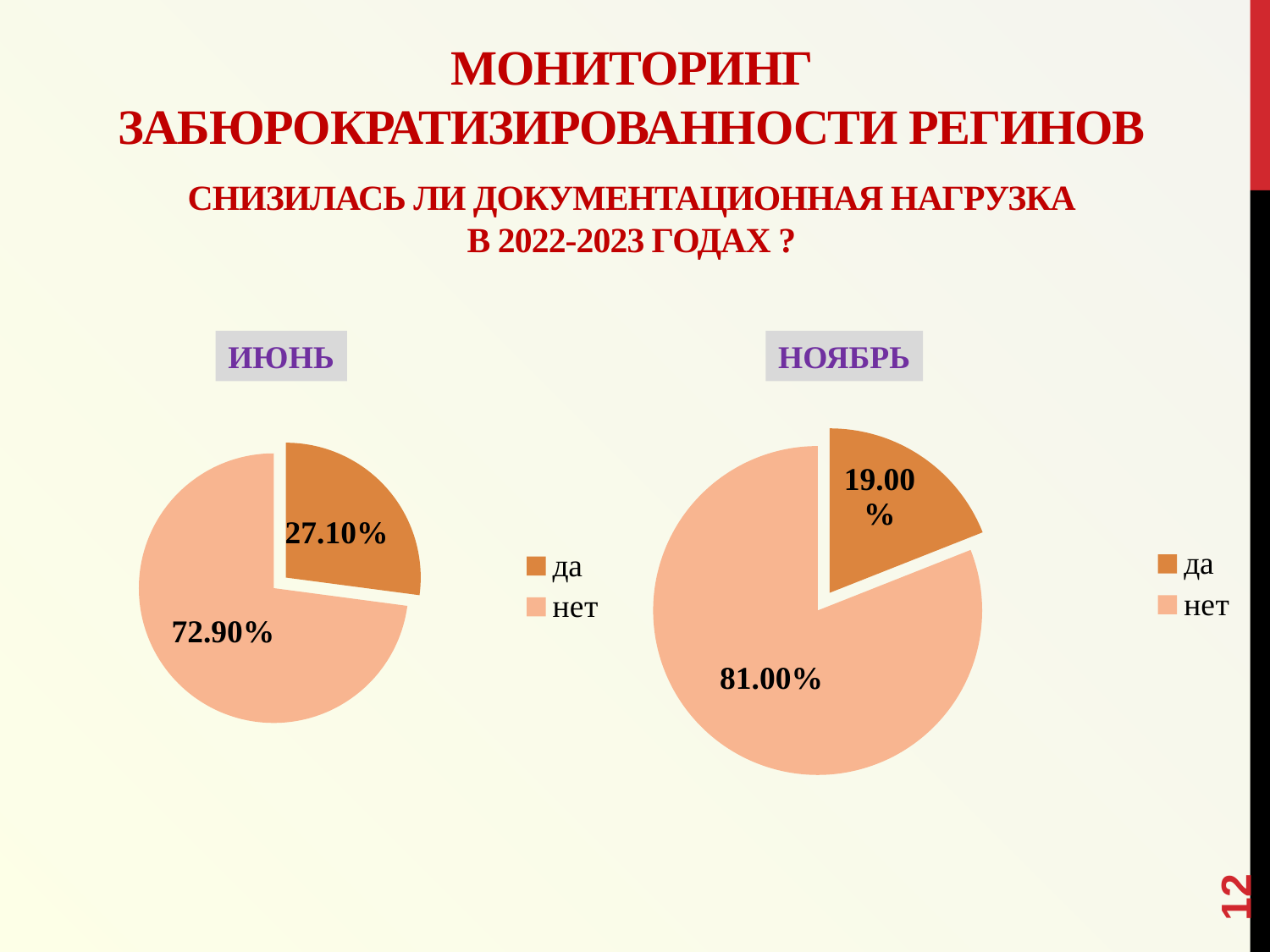
In the ИЮНЬ pie chart, what is the value for да? 27.10% In the ИЮНЬ pie chart, what is the difference between the нет and да values? 45.80% In the НОЯБРЬ pie chart, which slice is the smallest? да In the ИЮНЬ pie chart, which slice is the largest? нет In the НОЯБРЬ pie chart, what is the value for да? 19.00% How many entries does the legend of the ИЮНЬ chart list? 2 How many slices does the НОЯБРЬ pie chart have? 2 What type of chart is used on this slide? Pie chart Which chart has the larger value for да, ИЮНЬ or НОЯБРЬ? ИЮНЬ In the ИЮНЬ pie chart, what is the value for нет? 72.90% In the НОЯБРЬ pie chart, what is the difference between the нет and да values? 62.00% In the НОЯБРЬ pie chart, what is the value for нет? 81.00%